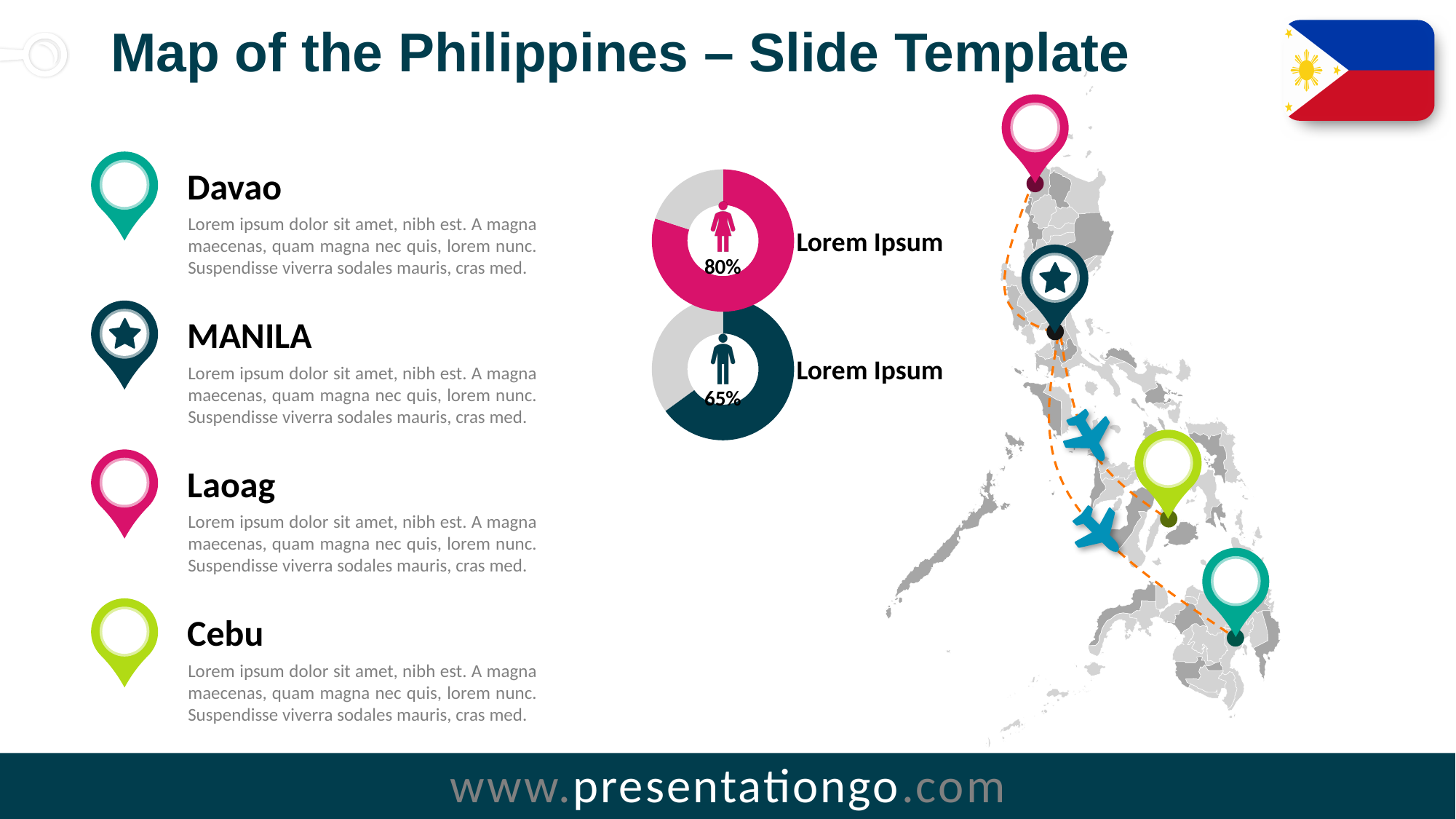
Is the value shown in the upper donut chart greater or less than 50%? greater What label text appears to the right of each donut chart? Lorem Ipsum What colour is the filled portion of the upper donut chart? Pink (magenta) What kind of charts are the two circular charts in the middle of the slide? Donut (pie) charts What percentage is shown in the upper donut chart (the pink one with the female icon)? 80% How many donut charts are on the slide? 2 Is the value shown in the lower donut chart greater or less than 50%? greater What share of the lower donut chart is left unfilled (grey)? 35% Which donut chart shows the larger percentage, the upper pink one or the lower dark teal one? The upper pink one (80%) What share of the upper donut chart is left unfilled (grey)? 20% What percentage is shown in the lower donut chart (the dark teal one with the male icon)? 65% What is the difference between the percentage in the upper donut chart and the percentage in the lower donut chart? 15 percentage points